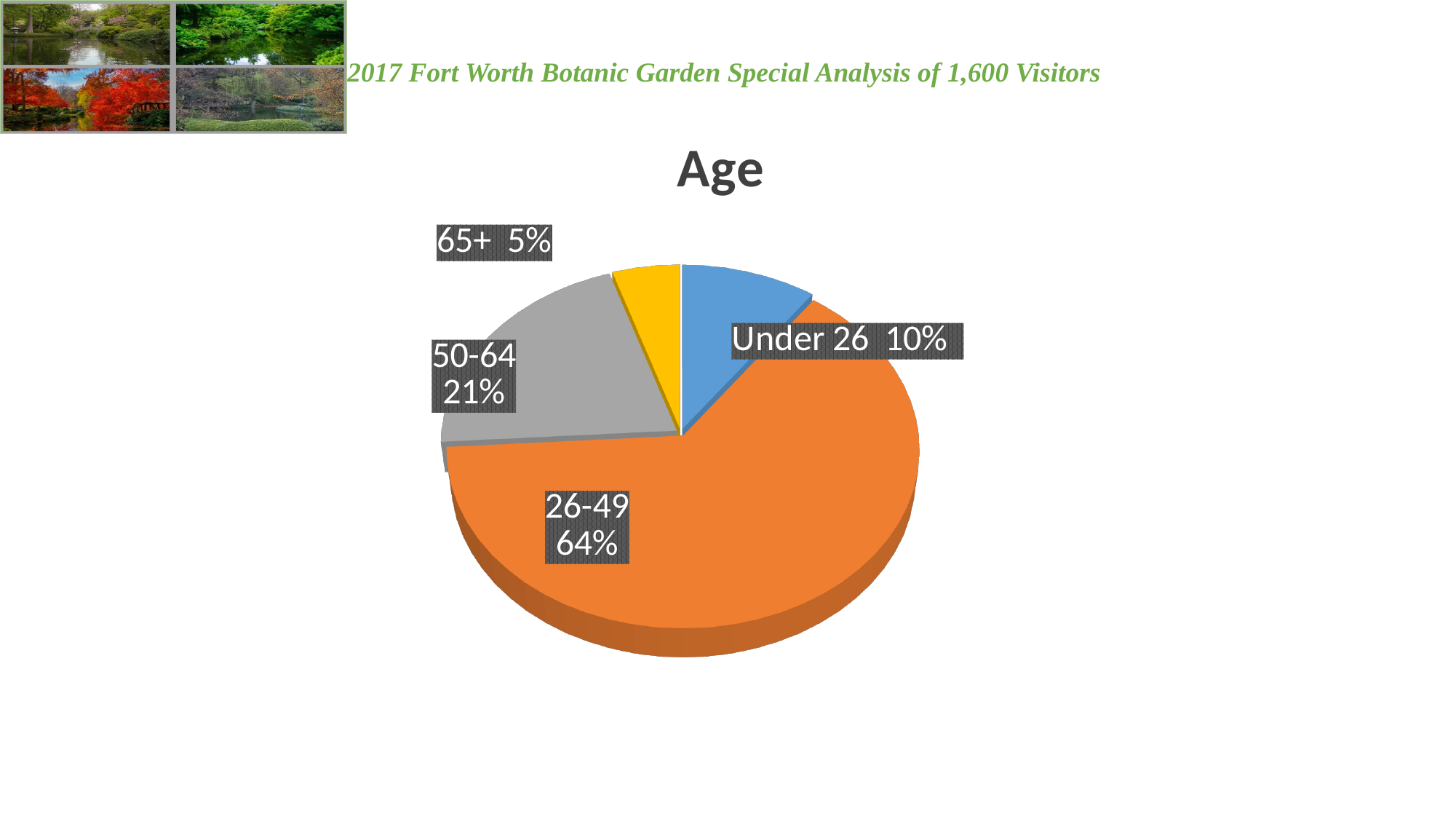
Which age group has the smallest share of visitors? 65+ Which age group has a larger share, 50-64 or Under 26? 50-64 How many percentage points larger is the Under 26 share than the 65+ share? 5 What share of visitors are aged 26-49? 64% How many percentage points larger is the 26-49 share than the 50-64 share? 43 What share of visitors are aged 50-64? 21% How many age groups are shown in the pie chart? 4 What share of visitors are Under 26? 10% What is the title of the chart? Age What kind of chart is shown on the slide? Pie chart Which age group has the largest share of visitors? 26-49